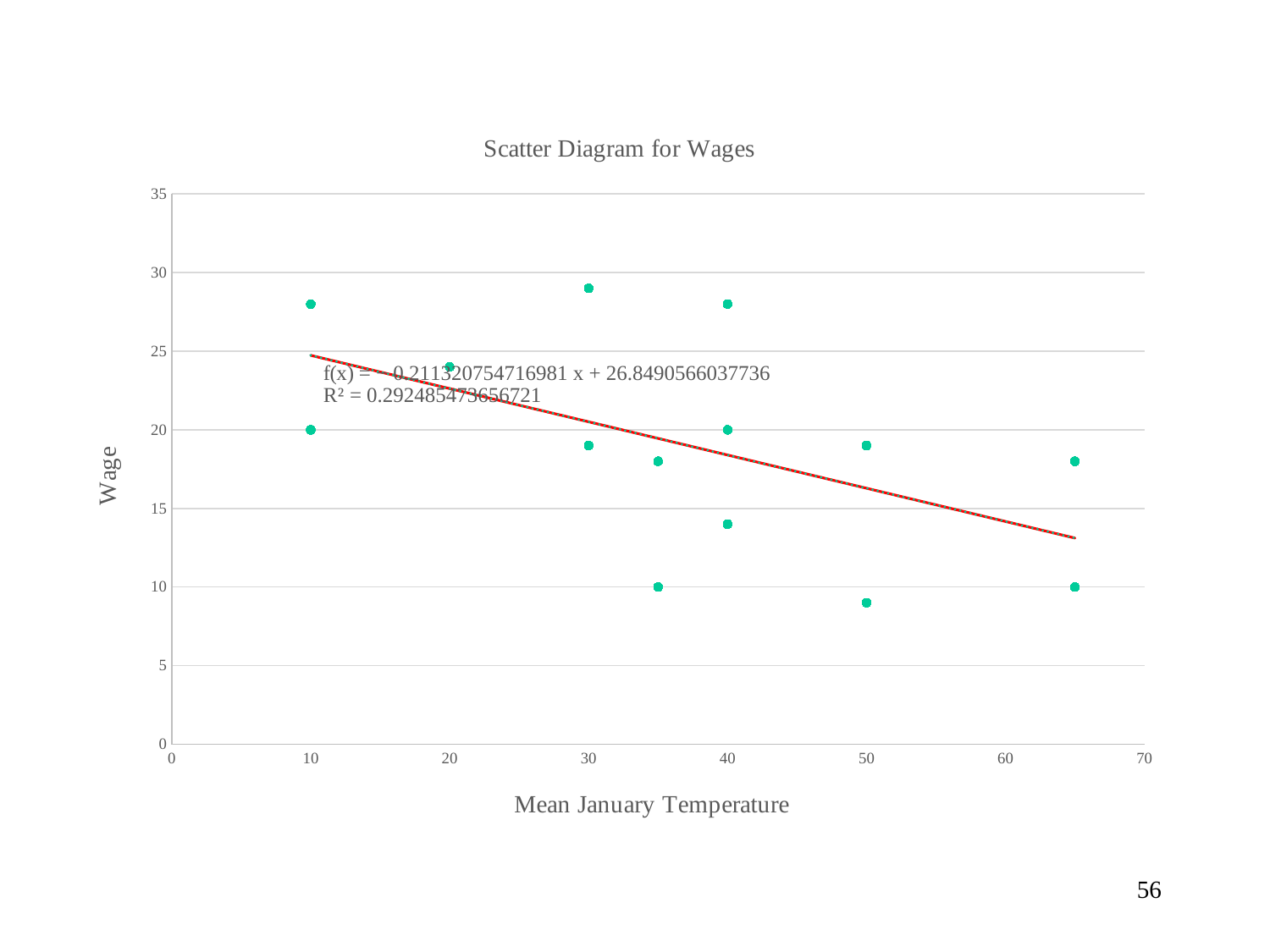
Which has the higher Wage: the upper point at a Mean January Temperature of 10 or the point at a Mean January Temperature of 20? The upper point at 10 What is the title of the chart? Scatter Diagram for Wages Which has the higher Wage: the point at a Mean January Temperature of 20 or the lower point at a Mean January Temperature of 30? The point at 20 What kind of chart is shown on the slide? Scatter chart How many data points are plotted at a Mean January Temperature of 40? 3 Is the Wage value of the point at a Mean January Temperature of 20 greater or less than 20? greater Is the Wage value of the highest point at a Mean January Temperature of 30 greater or less than 25? greater Is the Wage value of the lowest point at a Mean January Temperature of 50 greater or less than 10? less How many data points are plotted on the chart? 14 Does the fitted trend line rise or fall as Mean January Temperature increases? Fall What R² value is printed on the chart? 0.292485473656721